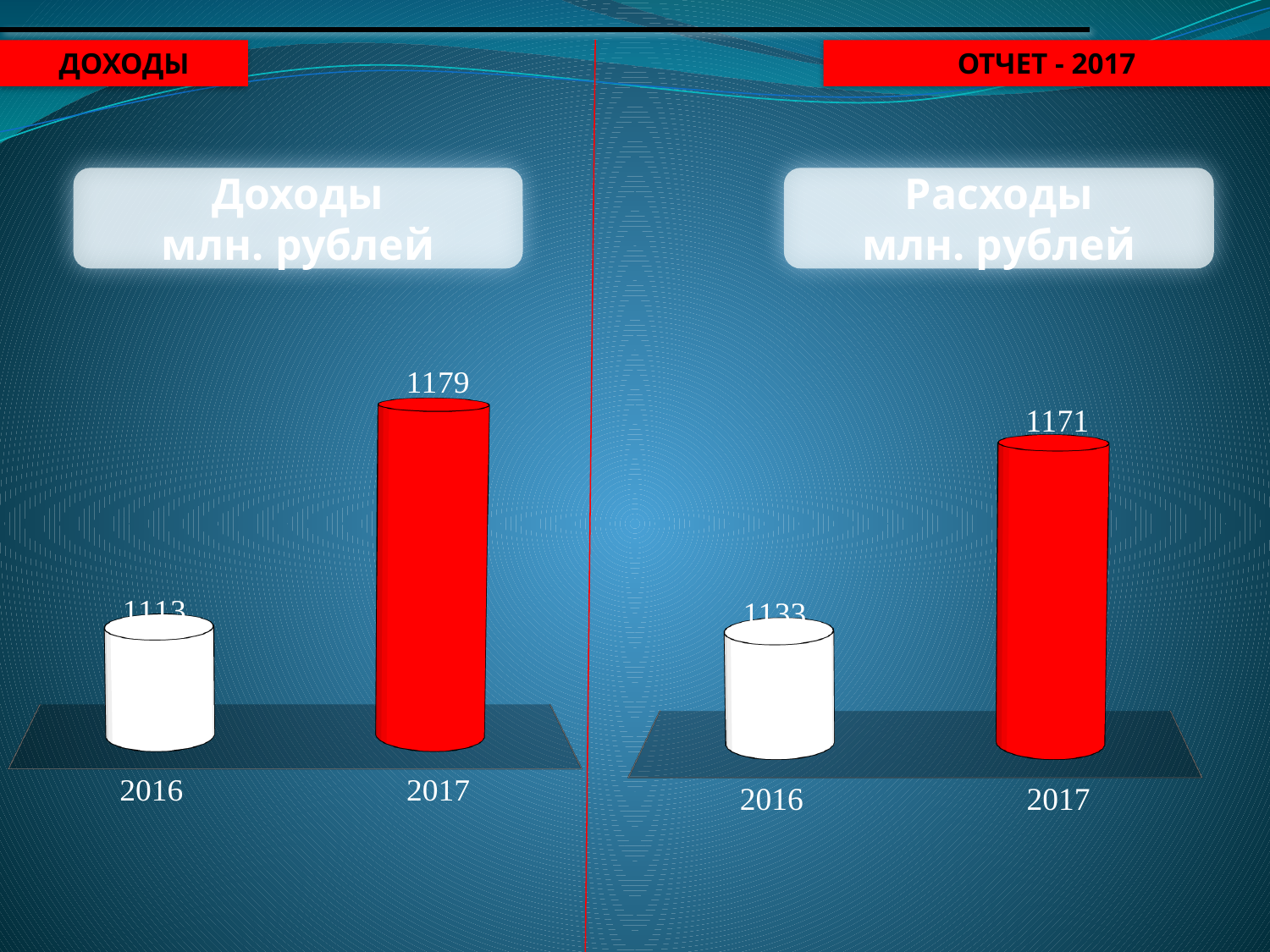
In the right chart (Расходы млн. рублей), do the values rise or fall from 2016 to 2017? rise In the left chart (Доходы млн. рублей), what is the value for 2017? 1179 In the left chart (Доходы млн. рублей), what is the value for 2016? 1113 In the left chart (Доходы млн. рублей), which year has the higher value? 2017 Is the 2017 value in the left chart (Доходы) larger or smaller than the 2017 value in the right chart (Расходы)? larger What kind of chart is the right chart (Расходы млн. рублей)? bar chart In the right chart (Расходы млн. рублей), what is the value for 2017? 1171 In the left chart (Доходы млн. рублей), what is the difference between the 2017 and 2016 values? 66 In the right chart (Расходы млн. рублей), what is the value for 2016? 1133 In the right chart (Расходы млн. рублей), what is the difference between the 2017 and 2016 values? 38 How many categories (years) are shown in the left chart (Доходы млн. рублей)? 2 In the right chart (Расходы млн. рублей), which year has the lower value? 2016